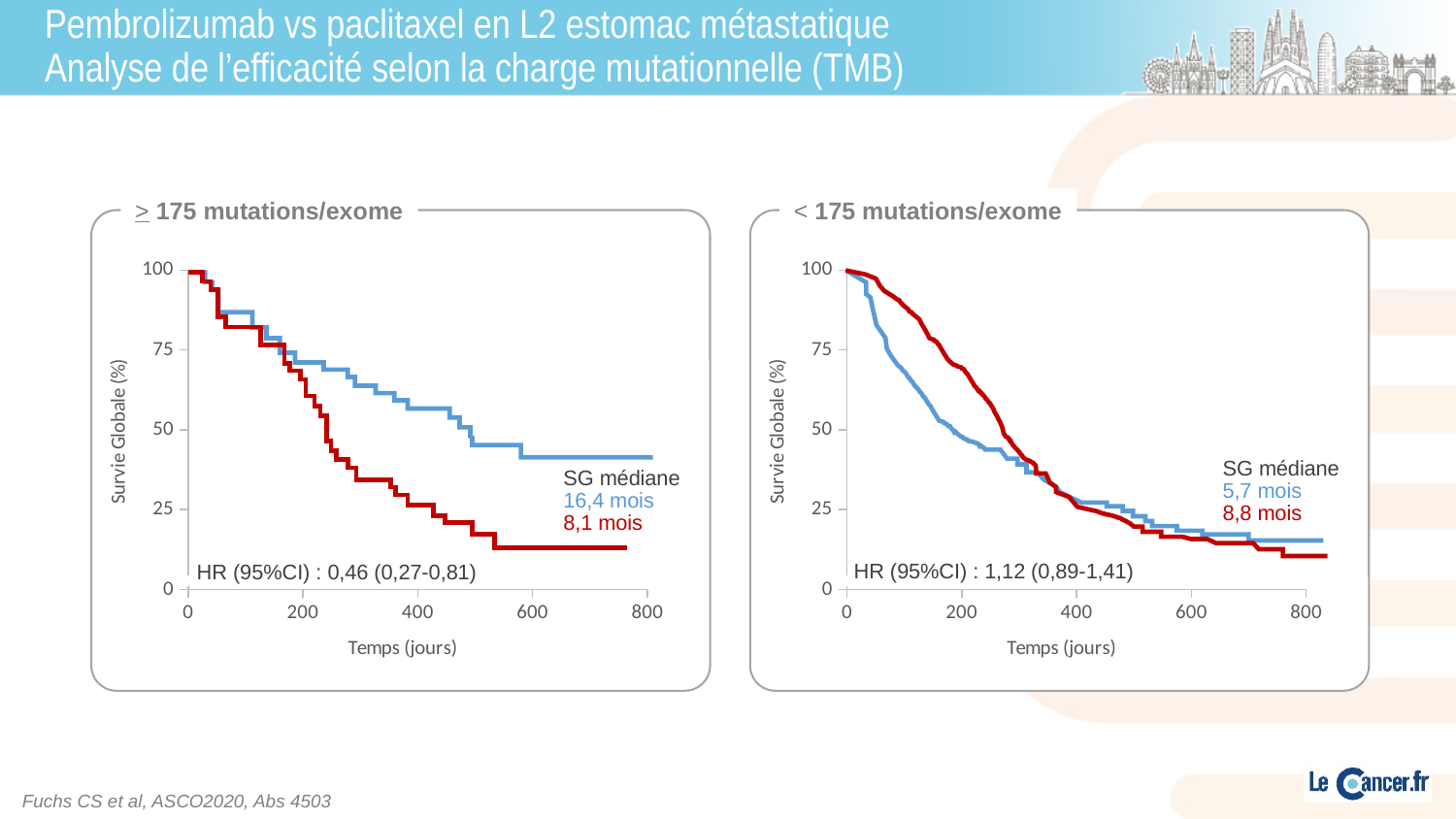
What hazard ratio (HR) with 95% CI is reported in the "< 175 mutations/exome" chart? 1,12 (0,89-1,41) In the "≥ 175 mutations/exome" chart, what is the median overall survival (SG médiane) for the red curve? 8,1 mois What kind of chart is shown in the "≥ 175 mutations/exome" panel? line chart In the "≥ 175 mutations/exome" chart, is the value of the blue curve at 600 days greater or less than 25? greater In the "< 175 mutations/exome" chart, what is the median overall survival (SG médiane) for the blue curve? 5,7 mois In the "≥ 175 mutations/exome" chart, what is the median overall survival (SG médiane) for the blue curve? 16,4 mois In the "≥ 175 mutations/exome" chart, what is the difference in median overall survival between the blue and red curves? 8,3 mois How many charts are shown on the slide? 2 What is the label of the y axis in both charts? Survie Globale (%) In the "< 175 mutations/exome" chart, which curve has the longer median overall survival, blue or red? red What hazard ratio (HR) with 95% CI is reported in the "≥ 175 mutations/exome" chart? 0,46 (0,27-0,81) In the "< 175 mutations/exome" chart, what is the median overall survival (SG médiane) for the red curve? 8,8 mois